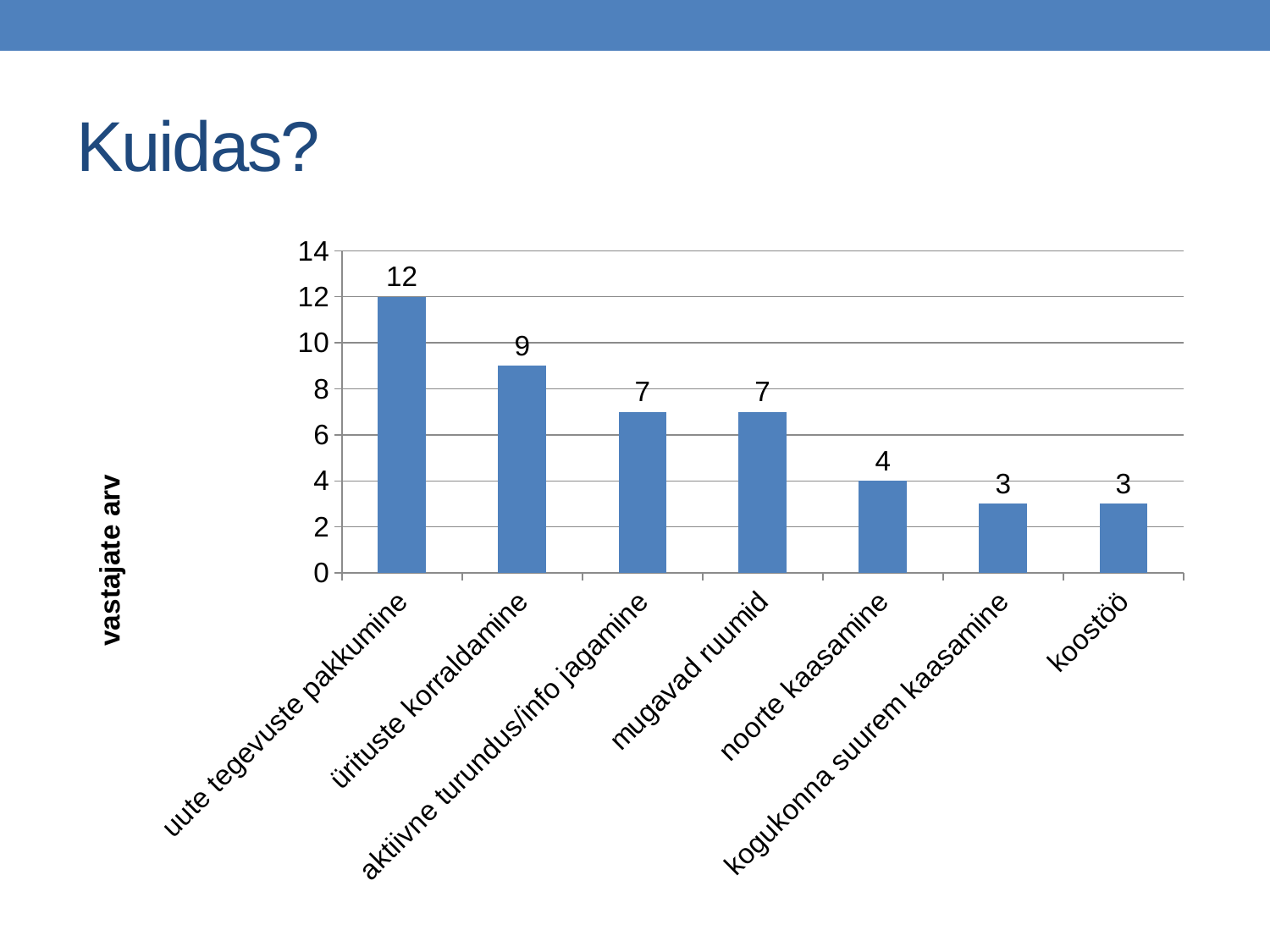
What is the value for "ürituste korraldamine"? 9 What is the difference between the values for "mugavad ruumid" and "noorte kaasamine"? 3 How many categories are shown in the chart? 7 Is the value for "ürituste korraldamine" greater or less than 10? less What is the value for "noorte kaasamine"? 4 What is the label of the vertical axis? vastajate arv What is the value for "koostöö"? 3 Which is larger, the value for "ürituste korraldamine" or the value for "aktiivne turundus/info jagamine"? ürituste korraldamine Which category has the highest value? uute tegevuste pakkumine What kind of chart is shown on the slide? bar chart What is the difference between the values for "uute tegevuste pakkumine" and "ürituste korraldamine"? 3 What is the value for "uute tegevuste pakkumine"? 12